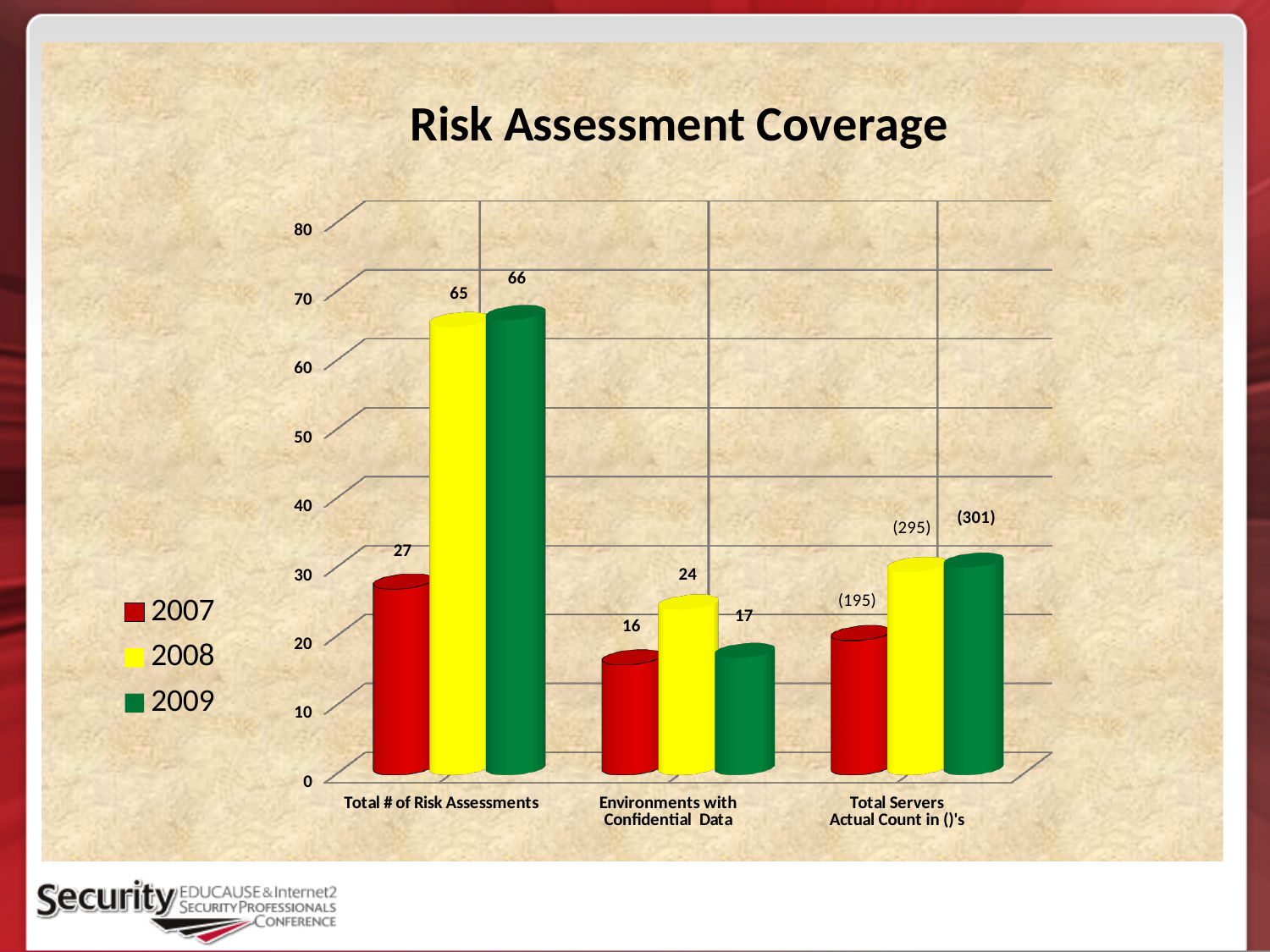
What actual count label is shown for 2009 in the Total Servers category? (301) Which year has the highest value in the Environments with Confidential Data category? 2008 How many categories are shown on the x axis? 3 Is the 2007 bar for Total # of Risk Assessments greater or less than 20? greater What is the difference between the 2008 and 2007 values for Total # of Risk Assessments? 38 Which is larger in the Environments with Confidential Data category: the 2007 value or the 2008 value? 2008 What is the title of the chart? Risk Assessment Coverage How many series does the legend list? 3 What is the value for 2008 in the Total # of Risk Assessments category? 65 What is the value for 2009 in the Total # of Risk Assessments category? 66 What is the value for 2007 in the Environments with Confidential Data category? 16 Which year has the lowest value in the Total # of Risk Assessments category? 2007